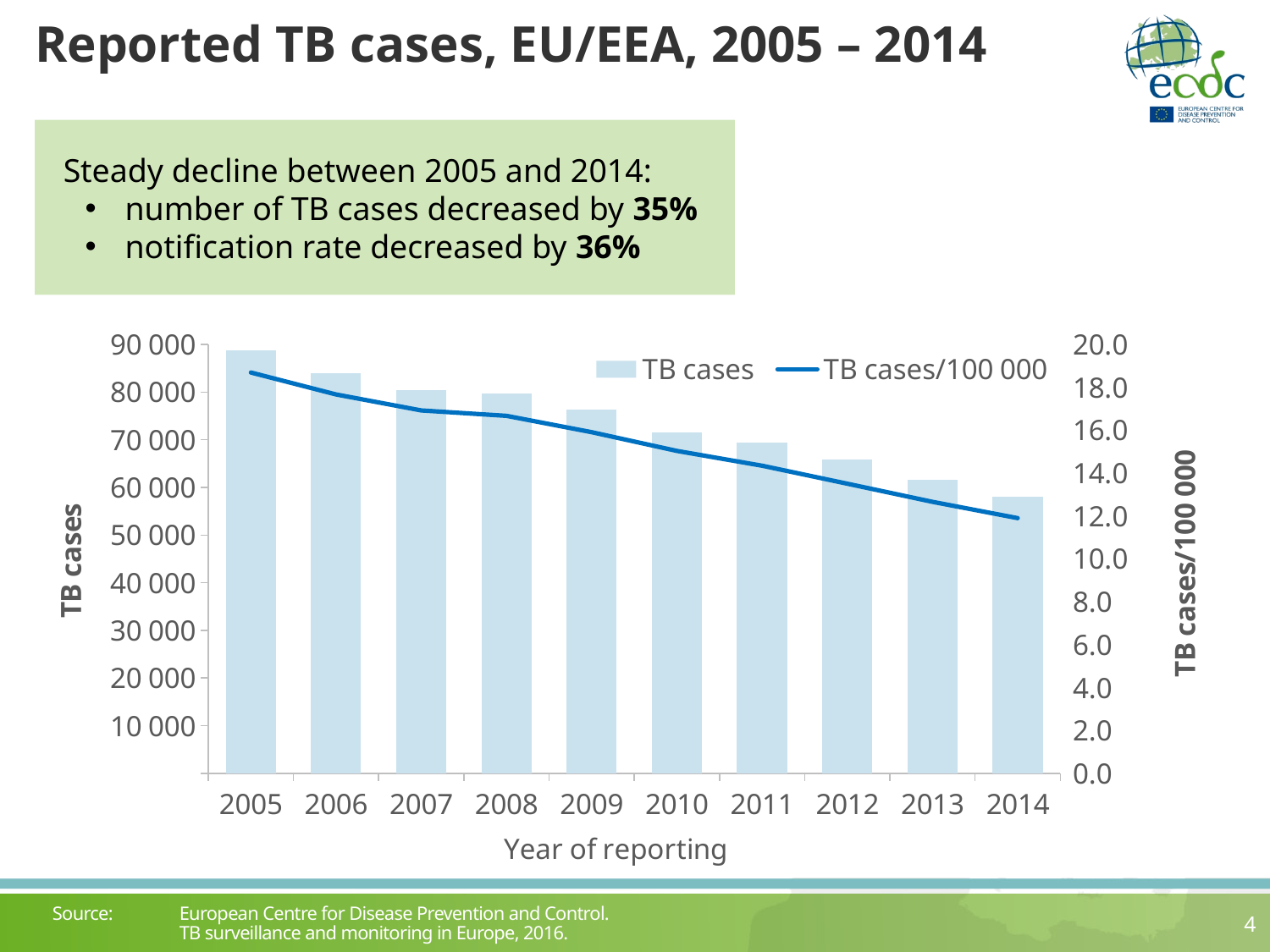
Which year has the highest number of TB cases in the chart? 2005 What kind of chart is shown on the slide? A combined bar and line chart Is the number of TB cases for 2005 greater or less than 80 000? greater How many series does the chart legend list? 2 Is the number of TB cases for 2012 greater or less than 70 000? less What are the two series named in the chart legend? TB cases and TB cases/100 000 Which year has the lowest number of TB cases in the chart? 2014 Is the TB cases/100 000 value for 2014 greater or less than 14.0? less How many years are shown on the x axis of the chart? 10 Do the TB cases rise or fall from 2005 to 2014? Fall Which year has more TB cases, 2007 or 2012? 2007 What is the title of the x axis of the chart? Year of reporting